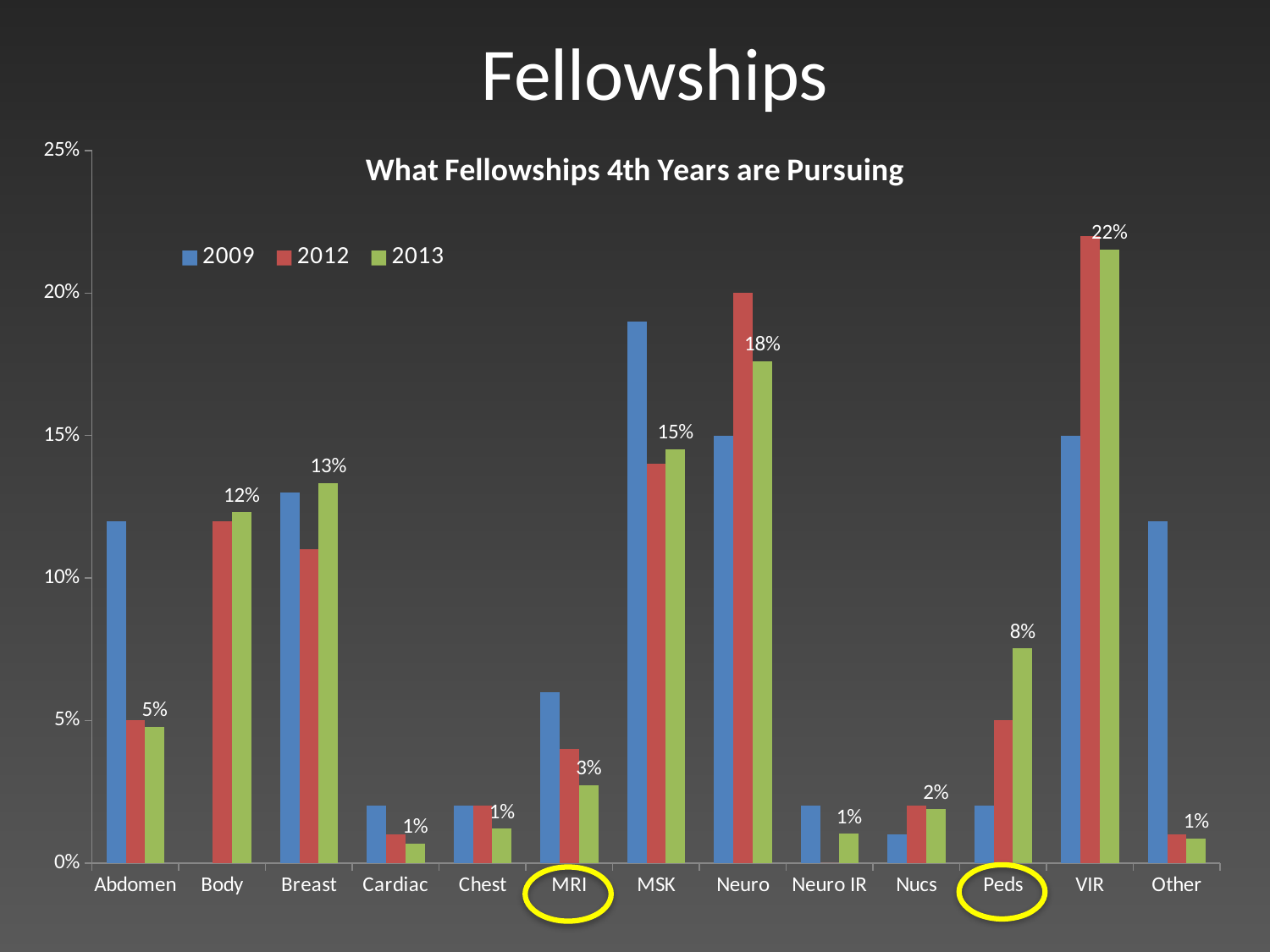
What kind of chart is shown on the slide? bar chart What is the 2013 value for Neuro? 18% How many series does the legend list? 3 What is the 2013 value for MRI? 3% What is the 2013 value for VIR? 22% Is the 2009 value for Abdomen greater or less than 10%? greater How many fellowship categories are shown on the x axis? 13 What is the 2013 value for Peds? 8% Which category has the highest 2013 value? VIR What is the difference between the 2013 values for VIR and Neuro? 4% Which is larger, the 2013 value for Neuro or the 2013 value for MSK? Neuro Is the 2012 value for Neuro greater or less than 15%? greater